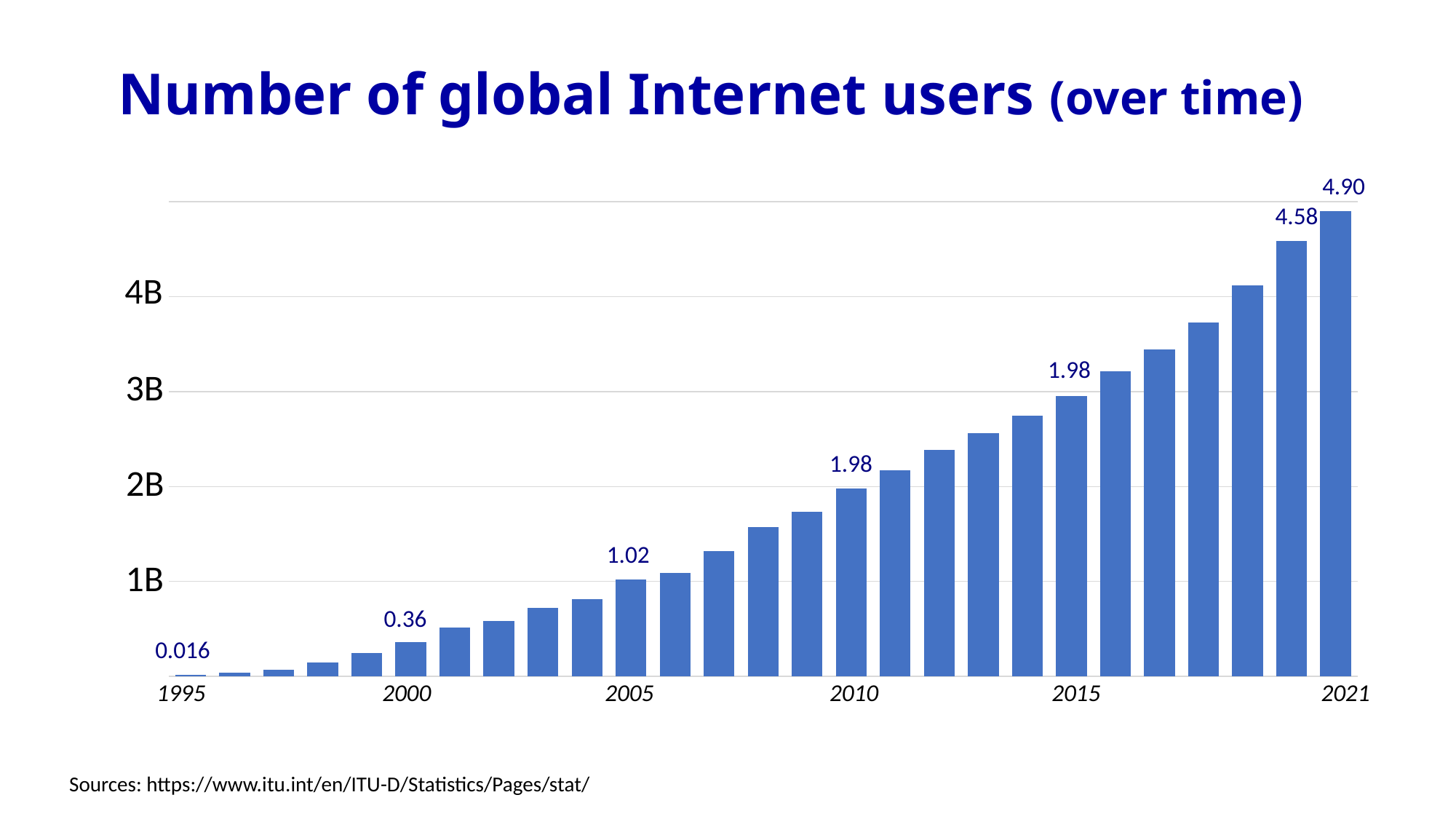
Do the values rise or fall from 1995 to 2021? rise Which year has the highest number of global Internet users? 2021 What is the value for 2005? 1.02 What is the value for 1995? 0.016 What kind of chart is shown on the slide? bar chart Which is larger, the value for 2005 or the value for 2010? 2010 Which year has the lowest number of global Internet users? 1995 What is the value for 2000? 0.36 What is the value for 2020? 4.58 What is the difference between the values for 2021 and 2020? 0.32 Is the value for 2015 greater or less than 2B? greater What is the value for 2021? 4.90